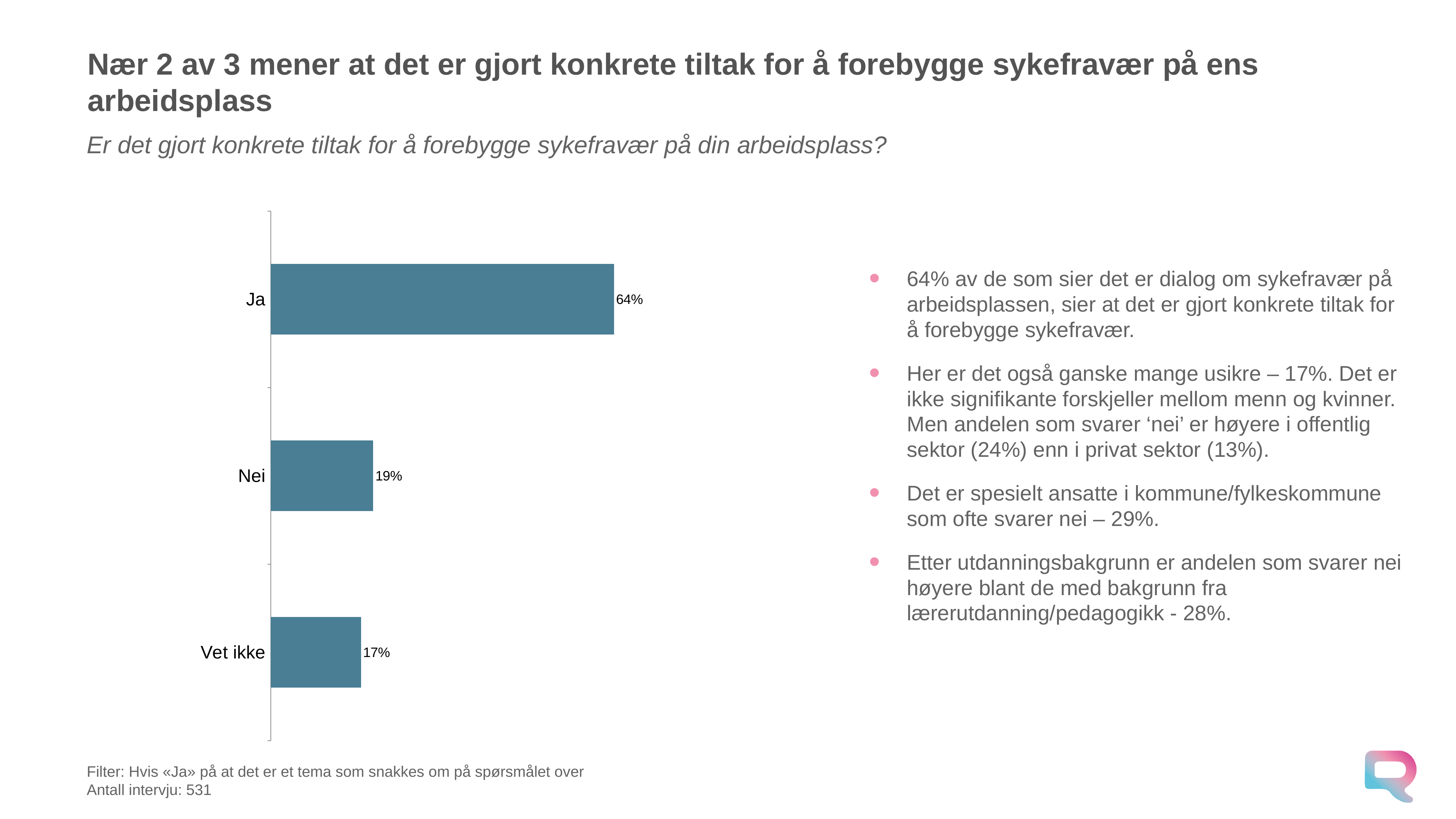
What is the difference between the values for "Ja" and "Nei"? 45% What is the value for "Vet ikke"? 17% Which category has the lowest value? Vet ikke Which is larger, the value for "Ja" or the value for "Vet ikke"? Ja What is the total of the three values shown in the chart? 100% Which category has the highest value? Ja What is the value for "Ja"? 64% What is the number of interviews (Antall intervju) stated below the chart? 531 How many categories are shown in the chart? 3 What kind of chart is shown on the slide? Bar chart What is the difference between the values for "Nei" and "Vet ikke"? 2% What is the value for "Nei"? 19%